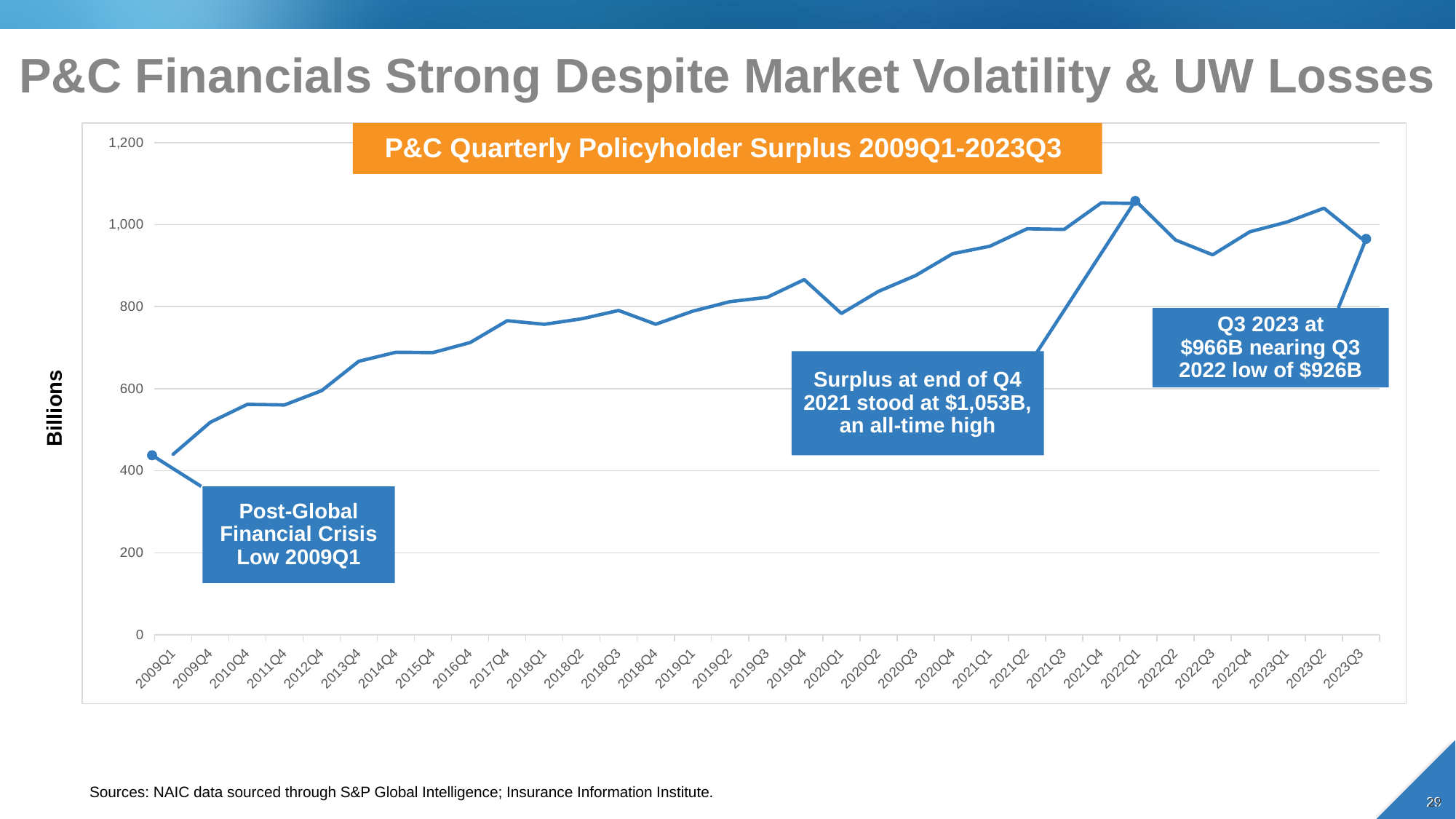
How much lower is the Q3 2023 surplus ($966B) than the Q4 2021 all-time high ($1,053B)? $87B What kind of chart is shown on the slide? Line chart Is the value for 2009Q1 greater or less than 600? less According to the chart annotation, what was the Q3 2022 low in policyholder surplus? $926B Which quarter is identified as the post-Global Financial Crisis low on the chart? 2009Q1 What is the title of the chart? P&C Quarterly Policyholder Surplus 2009Q1-2023Q3 According to the chart annotation, what was the policyholder surplus at the end of Q4 2021? $1,053B Overall, does the policyholder surplus rise or fall from 2009Q1 to 2023Q3? Rise How much higher is the Q3 2023 surplus ($966B) than the Q3 2022 low ($926B)? $40B According to the chart annotation, what was the policyholder surplus in Q3 2023? $966B Is the value for 2023Q2 greater or less than 1,000? greater What is the label on the vertical axis of the chart? Billions